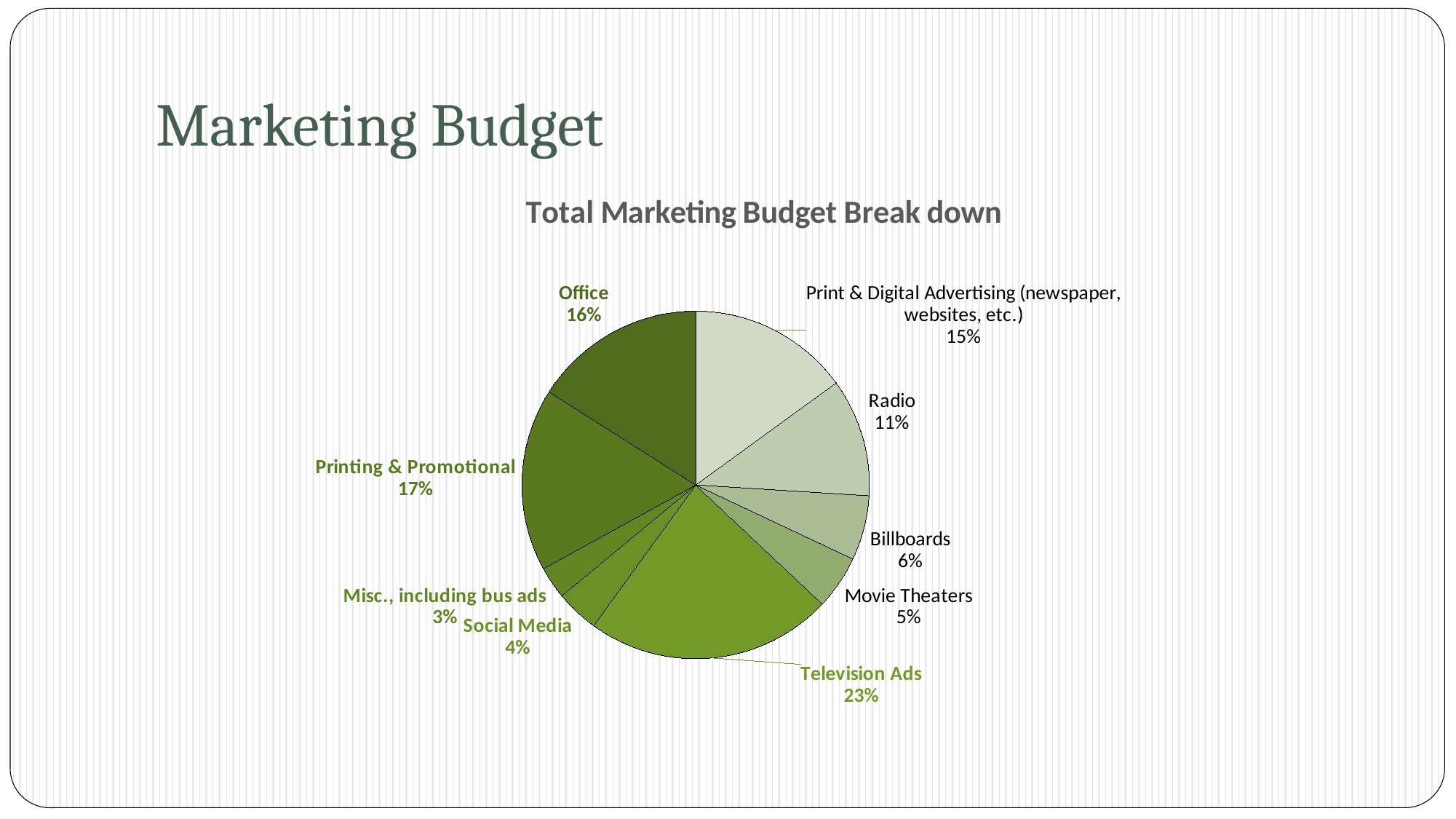
What is the difference between the Print & Digital Advertising share and the Radio share? 4% What share of the budget goes to Social Media? 4% Which category has the smallest share of the budget? Misc., including bus ads Which category has the largest share of the budget? Television Ads What type of chart is shown on the slide? Pie chart How many categories are shown in the pie chart? 9 What is the difference between the Television Ads share and the Office share? 7% What is the title of the chart? Total Marketing Budget Break down What share of the budget goes to Printing & Promotional? 17% What share of the budget goes to Television Ads? 23% Which is larger, the share for Billboards or the share for Movie Theaters? Billboards